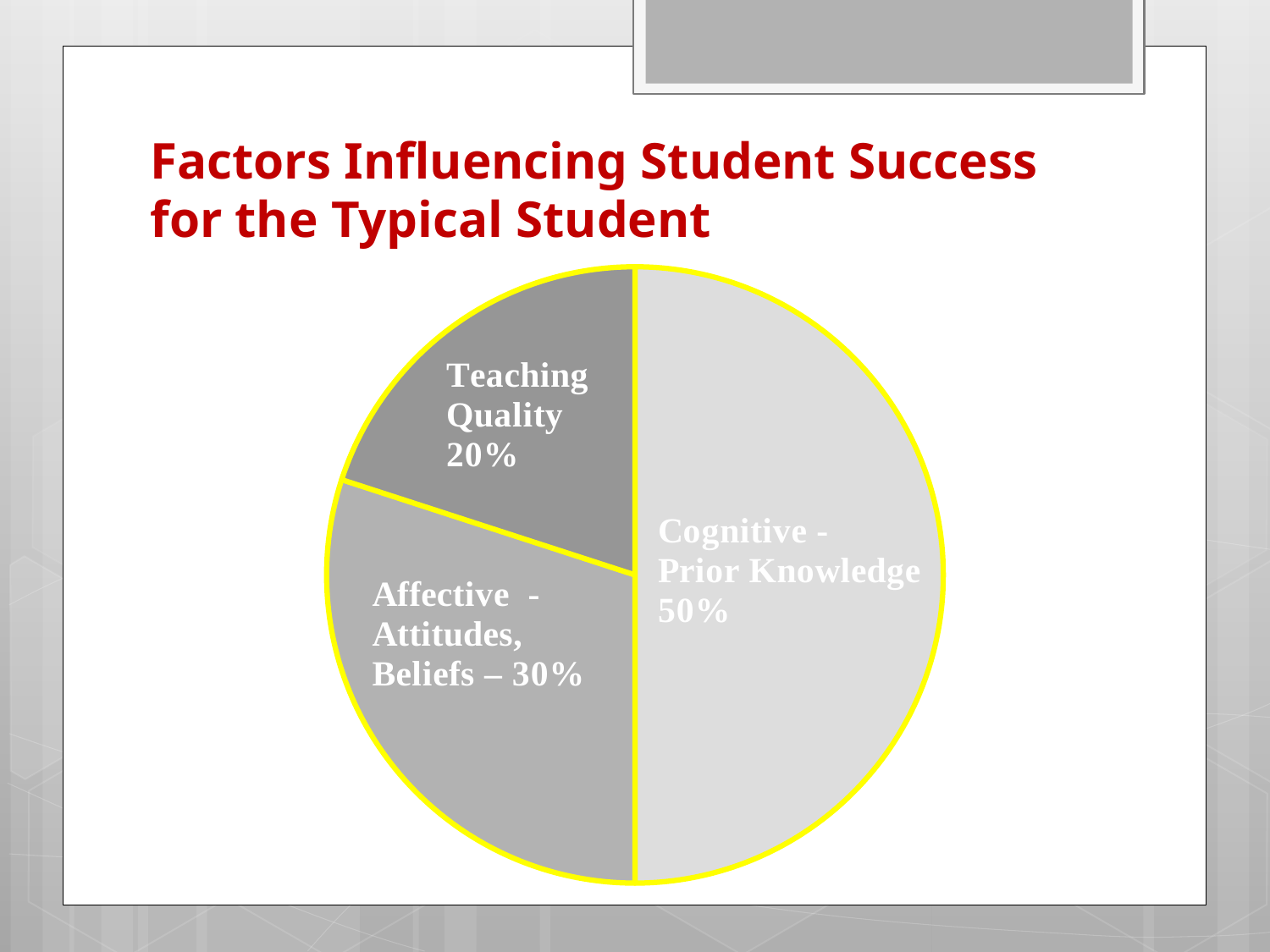
What share of the pie does Cognitive - Prior Knowledge represent? 50% What share of the pie does Affective - Attitudes, Beliefs represent? 30% Which slice of the pie is the largest? Cognitive - Prior Knowledge What is the difference in percentage points between the Affective - Attitudes, Beliefs slice and the Teaching Quality slice? 10 What share of the pie does Teaching Quality represent? 20% Which is larger, the Affective - Attitudes, Beliefs slice or the Teaching Quality slice? Affective - Attitudes, Beliefs What is the title of the slide containing the pie chart? Factors Influencing Student Success for the Typical Student What kind of chart is shown on the slide? pie chart What colour are the borders between the slices of the pie chart? yellow What is the difference in percentage points between the Cognitive - Prior Knowledge slice and the Teaching Quality slice? 30 Which slice of the pie is the smallest? Teaching Quality How many slices does the pie chart have? 3